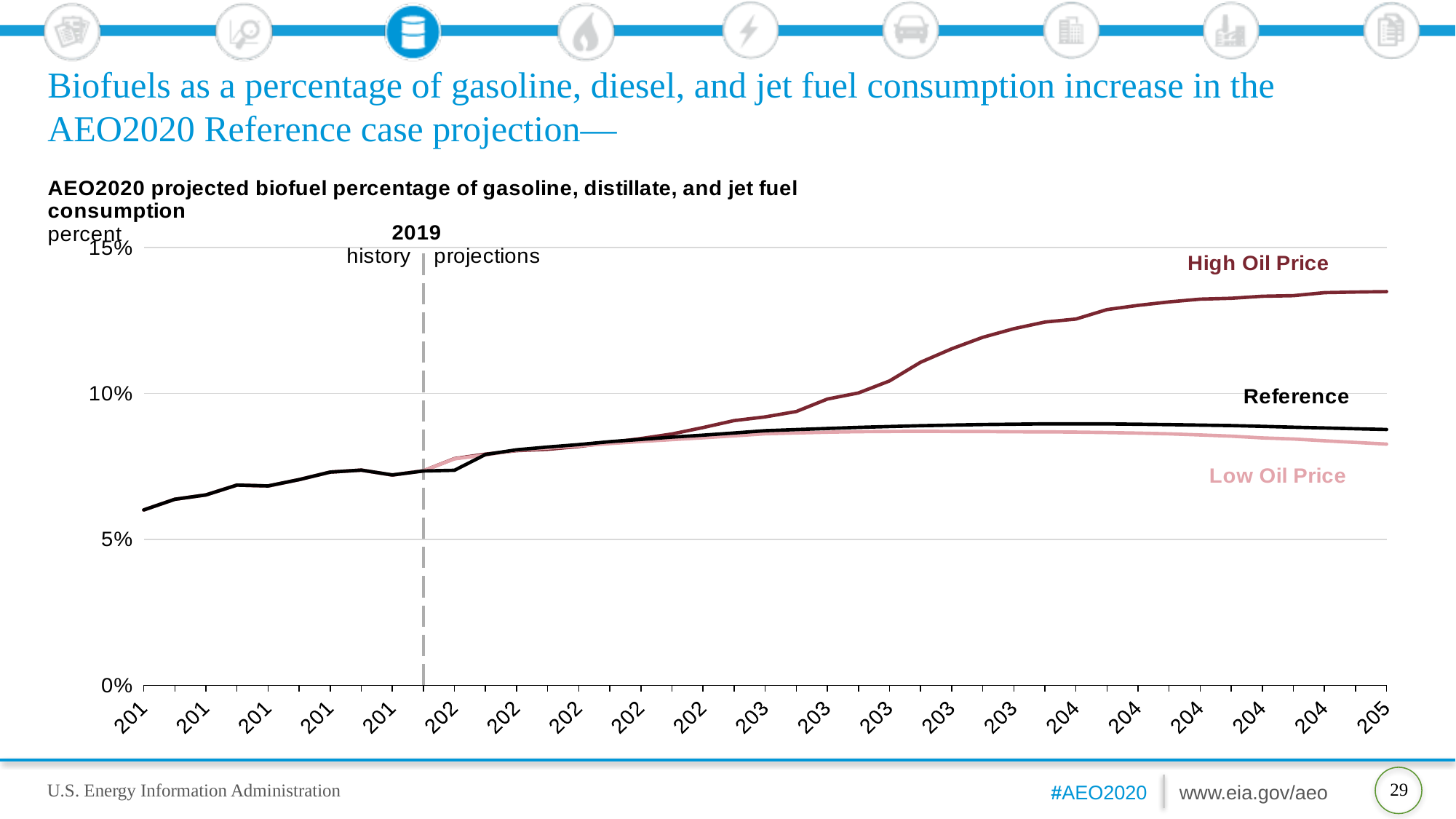
What unit is shown on the vertical axis of the chart? percent What year does the dashed vertical line separating history from projections mark? 2019 At the right end of the chart, is the High Oil Price value greater or less than 10%? greater At the right end of the chart, which is larger: the High Oil Price value or the Low Oil Price value? High Oil Price At the 2019 dashed line, is the plotted value greater or less than 5%? greater Does the High Oil Price line rise or fall across the projection period? rise How many series are labeled on the chart? 3 Which series has the highest value at the right end of the chart? High Oil Price At the right end of the chart, is the Low Oil Price value greater or less than 10%? less What kind of chart is shown on the slide? line chart Which series has the lowest value at the right end of the chart? Low Oil Price